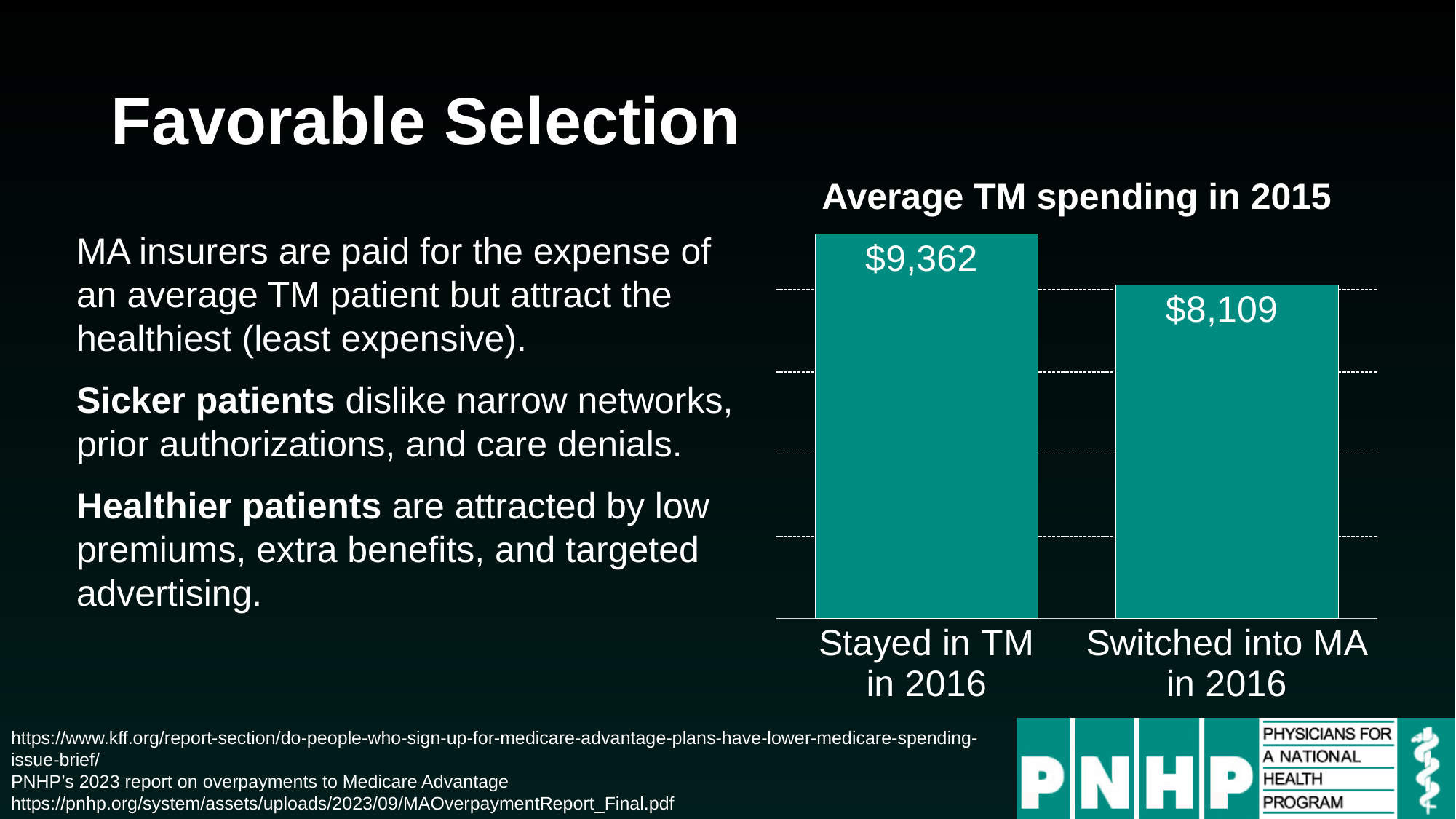
What is the average TM spending in 2015 for those who stayed in TM in 2016? $9,362 Which group has the lower average TM spending in 2015? Switched into MA in 2016 Which group has the higher average TM spending in 2015? Stayed in TM in 2016 Is the average TM spending in 2015 larger for those who stayed in TM or those who switched into MA? Stayed in TM What colour are the bars in the chart? Teal What is the title of the chart? Average TM spending in 2015 What kind of chart is shown on the slide? Bar chart What is the average TM spending in 2015 for those who switched into MA in 2016? $8,109 How many categories are shown in the chart? 2 What is the difference in average TM spending in 2015 between those who stayed in TM and those who switched into MA? $1,253